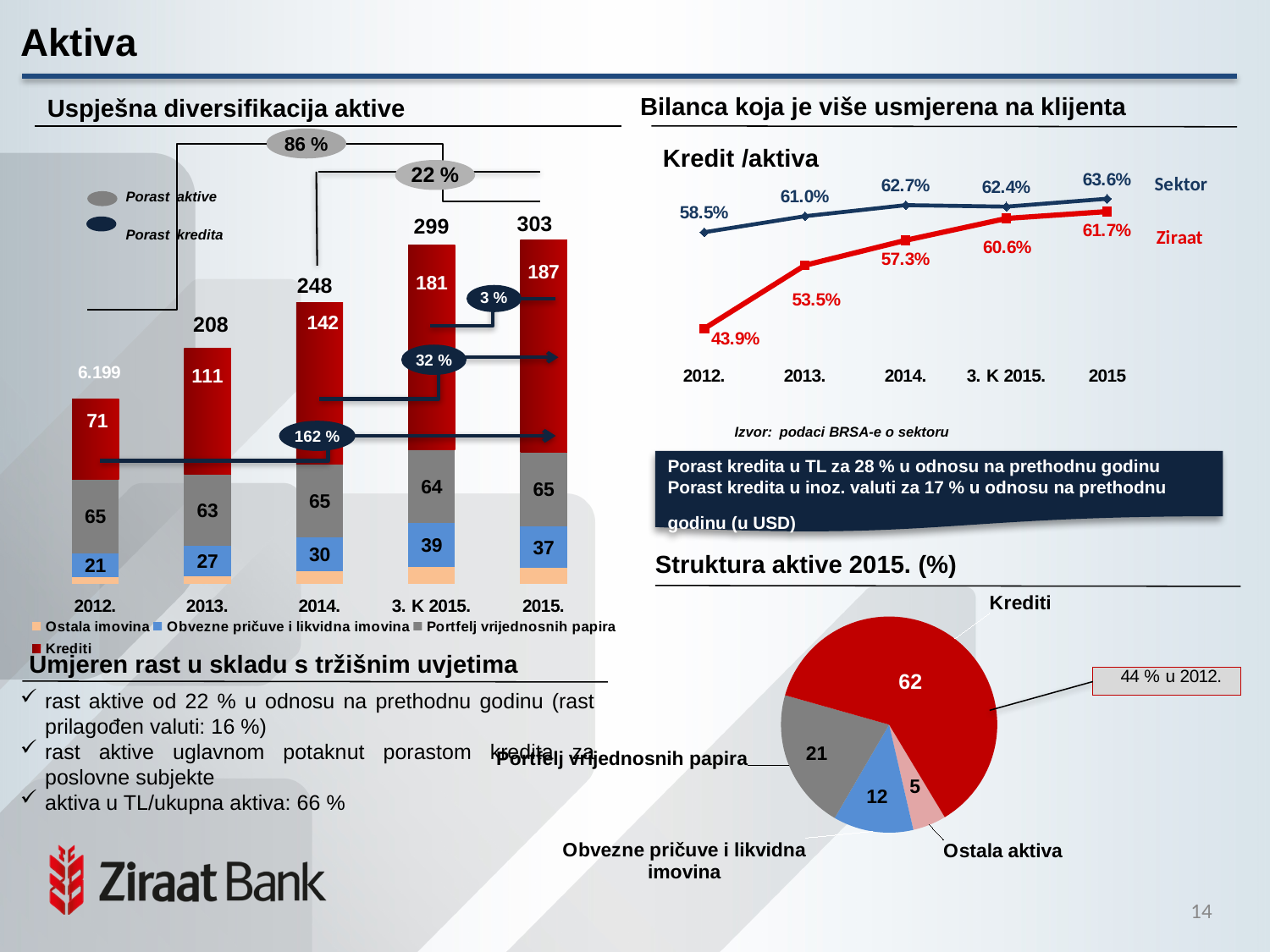
In the 'Kredit /aktiva' line chart, how many series are plotted? 2 In the 'Kredit /aktiva' line chart, what is the difference between the Sektor and Ziraat values in 2012.? 14.6% In the pie chart 'Struktura aktive 2015. (%)', what is the value of the Krediti slice? 62 In the stacked bar chart 'Uspješna diversifikacija aktive', what is the Krediti value for 2014.? 142 In the 'Kredit /aktiva' line chart, which year has the lowest Ziraat value? 2012. In the 'Kredit /aktiva' line chart, does the Ziraat line rise or fall from 2012. to 2015? rise In the 'Kredit /aktiva' line chart, what is the Sektor value for 2015? 63.6% In the stacked bar chart 'Uspješna diversifikacija aktive', which year has the highest Krediti value? 2015. In the stacked bar chart 'Uspješna diversifikacija aktive', how many entries does the legend list? 4 In the 'Kredit /aktiva' line chart, what is the Ziraat value for 2012.? 43.9% In the stacked bar chart 'Uspješna diversifikacija aktive', what is the total of the bar for 2015.? 303 In the pie chart 'Struktura aktive 2015. (%)', which slice is the smallest? Ostala aktiva